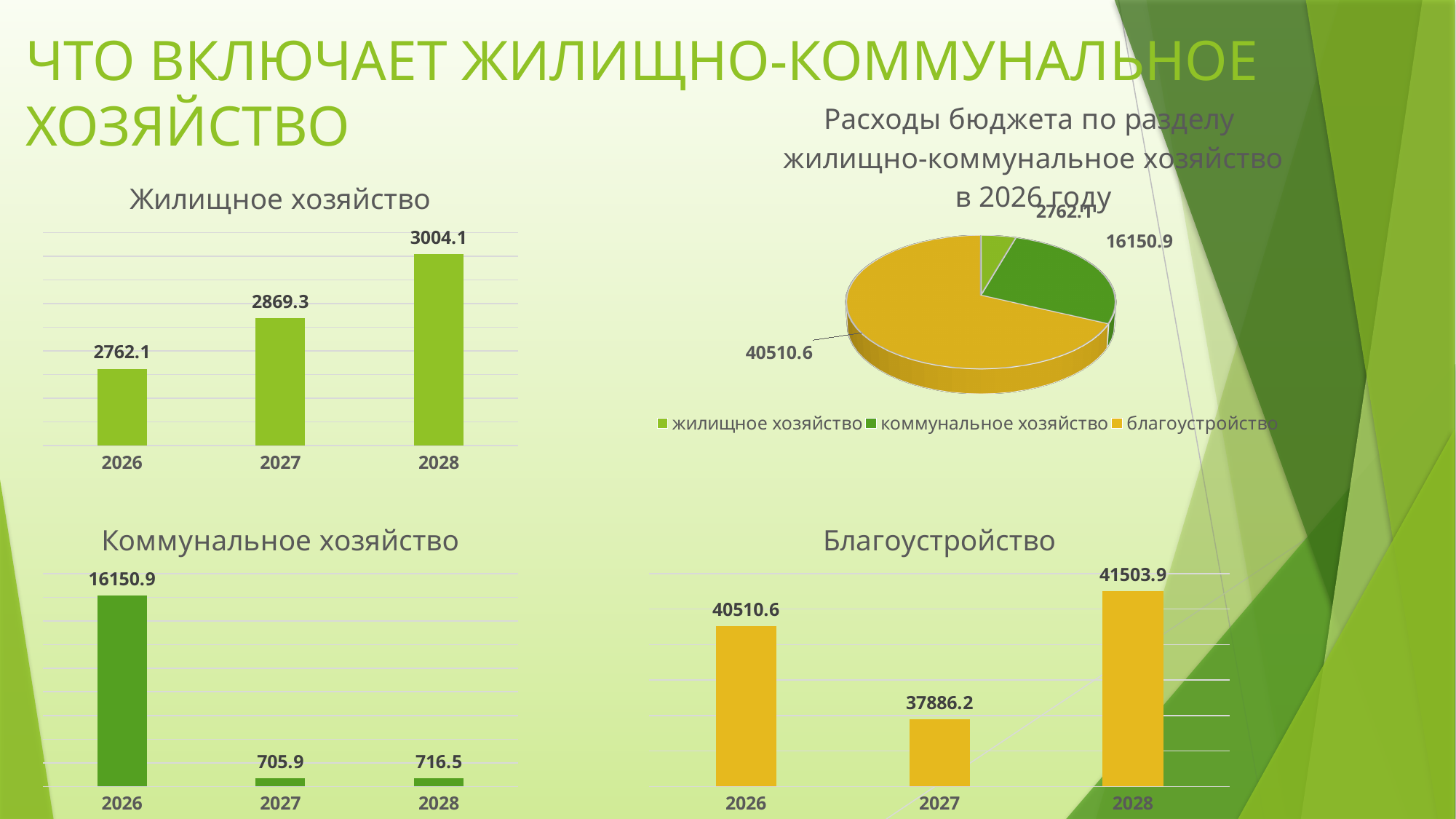
In the "Благоустройство" chart, which year has the lowest value? 2027 In the "Жилищное хозяйство" chart, do the values rise or fall from 2026 to 2028? rise In the "Коммунальное хозяйство" chart, which year has the highest value? 2026 In the "Благоустройство" chart, what is the value for 2028? 41503.9 In the "Коммунальное хозяйство" chart, what is the value for 2027? 705.9 In the "Коммунальное хозяйство" chart, which is larger, the value for 2027 or 2028? 2028 In the "Жилищное хозяйство" chart, what is the difference between the 2028 and 2026 values? 242.0 How many entries does the legend of the pie chart "Расходы бюджета по разделу жилищно-коммунальное хозяйство в 2026 году" list? 3 In the "Благоустройство" chart, what is the difference between the 2026 and 2027 values? 2624.4 In the pie chart "Расходы бюджета по разделу жилищно-коммунальное хозяйство в 2026 году", what is the value of the "благоустройство" slice? 40510.6 How many categories does the "Благоустройство" chart show? 3 In the "Жилищное хозяйство" chart, what is the value for 2028? 3004.1